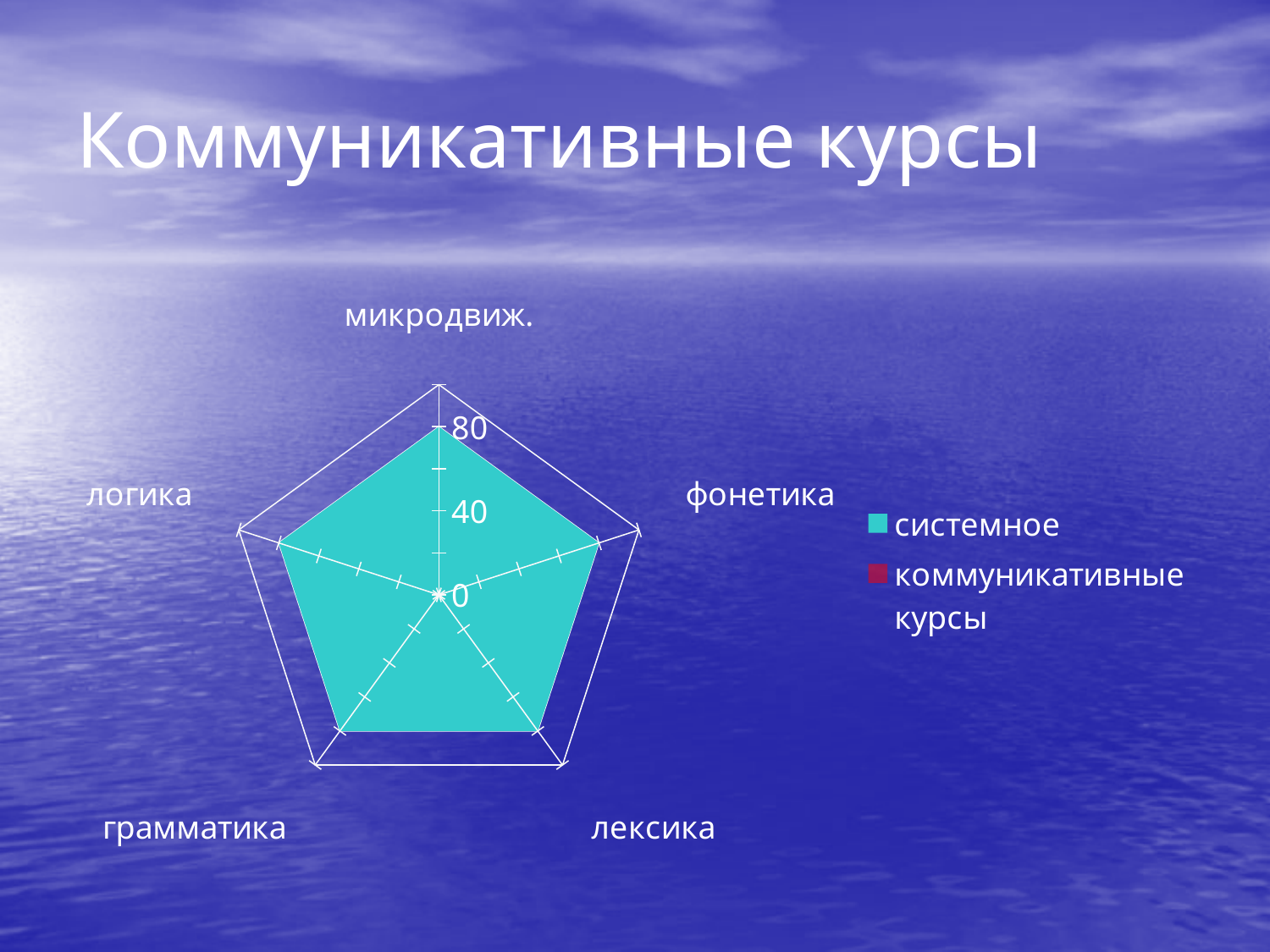
What kind of chart is shown on the slide? radar chart How many series does the legend list? 2 What is the highest tick label shown on the radar chart's axis? 80 Is the value for микродвиж. in the системное series greater or less than 40? greater Is the value for лексика in the системное series greater or less than 40? greater Is the value for фонетика in the системное series greater or less than 40? greater How many categories (axes) does the radar chart have? 5 What are the two series named in the legend? системное, коммуникативные курсы What value does the системное series reach on the микродвиж. axis? 80 What is the title of the slide containing the chart? Коммуникативные курсы